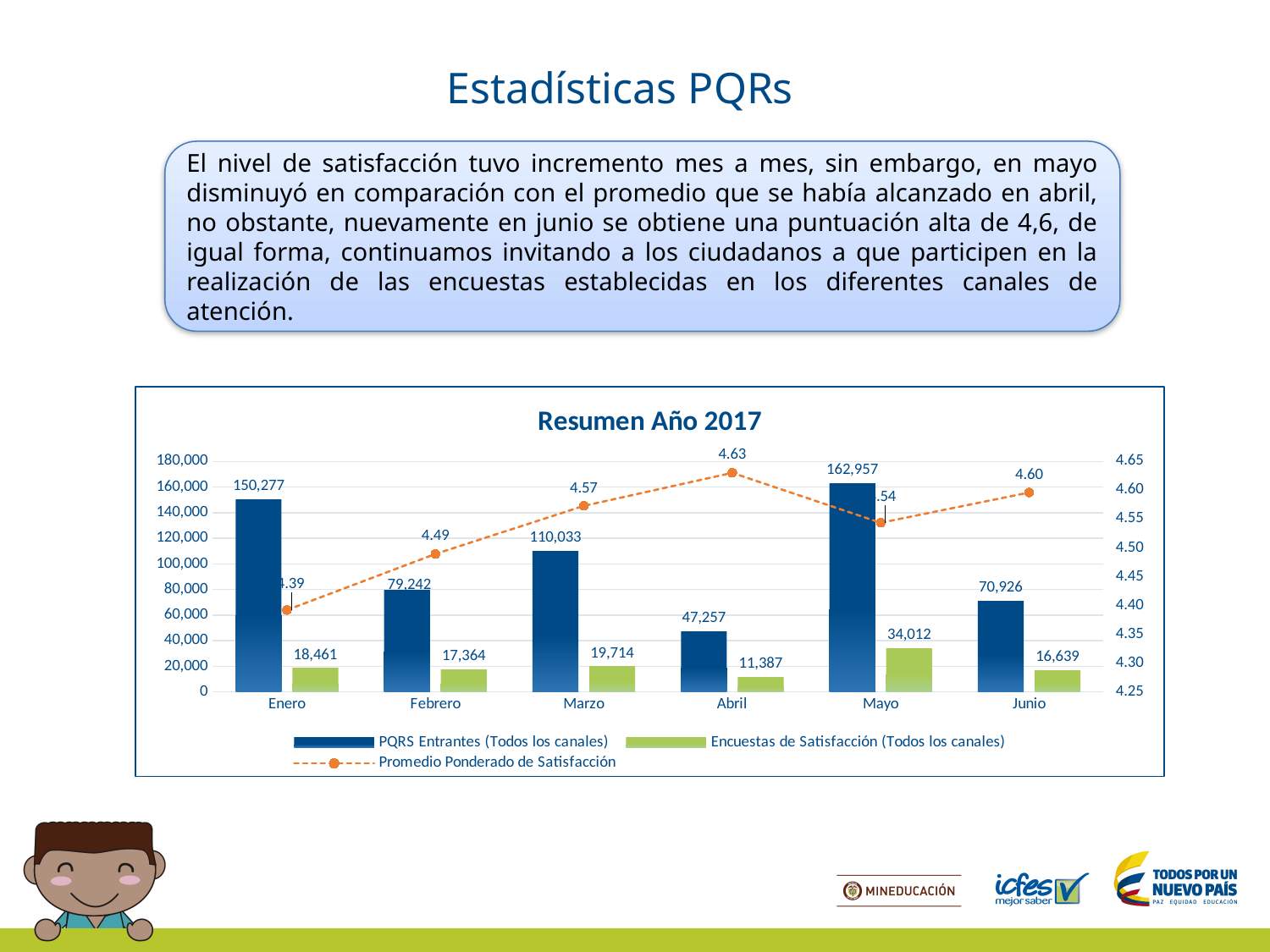
How many series does the legend list? 3 What is the Promedio Ponderado de Satisfacción for Abril? 4.63 What is the title of the chart? Resumen Año 2017 What kind of chart is shown on the slide? Combined bar and line chart Does the Promedio Ponderado de Satisfacción rise or fall from Enero to Abril? Rise What is the value of Encuestas de Satisfacción (Todos los canales) for Marzo? 19,714 What is the value of PQRS Entrantes (Todos los canales) for Mayo? 162,957 Which month has the highest value of PQRS Entrantes (Todos los canales)? Mayo What is the difference between PQRS Entrantes for Enero and Febrero? 71,035 Which month has the lowest value of Encuestas de Satisfacción (Todos los canales)? Abril Which is larger, the Encuestas de Satisfacción value for Enero or for Junio? Enero How many months are shown on the x axis? 6